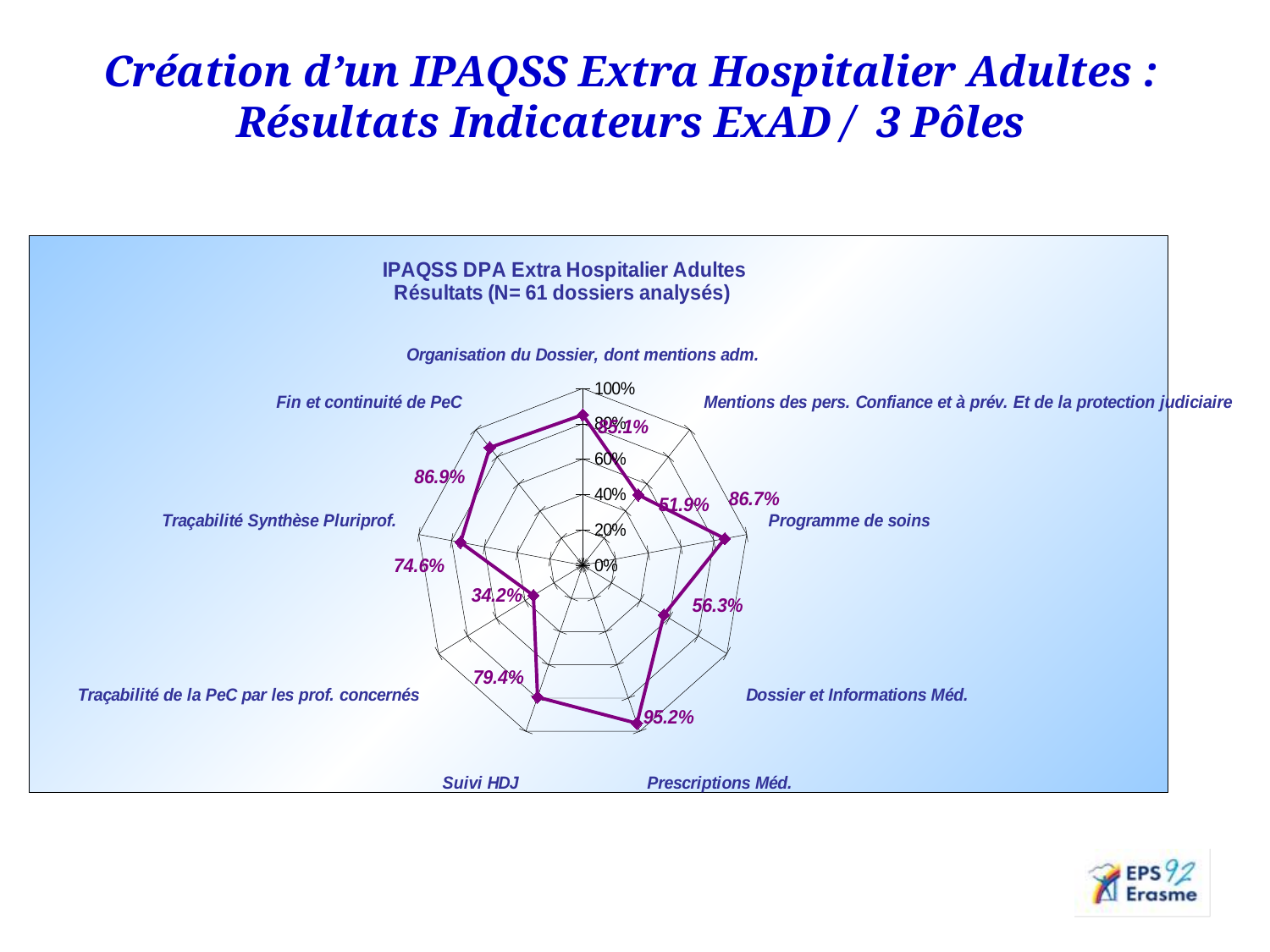
How many indicators are plotted on the chart? 9 Which is larger, the value for Suivi HDJ or the value for Dossier et Informations Méd.? Suivi HDJ Which indicator has the highest value? Prescriptions Méd. What is the difference between the values for Prescriptions Méd. and Traçabilité de la PeC par les prof. concernés? 61.0% Is the value for Traçabilité Synthèse Pluriprof. greater or less than 60%? greater What is the value for Traçabilité de la PeC par les prof. concernés? 34.2% What kind of chart is shown on the slide? Radar chart What is the value for Programme de soins? 86.7% What is the value for Suivi HDJ? 79.4% What is the value for Prescriptions Méd.? 95.2% Which indicator has the lowest value? Traçabilité de la PeC par les prof. concernés What is the value for Mentions des pers. Confiance et à prév. Et de la protection judiciaire? 51.9%